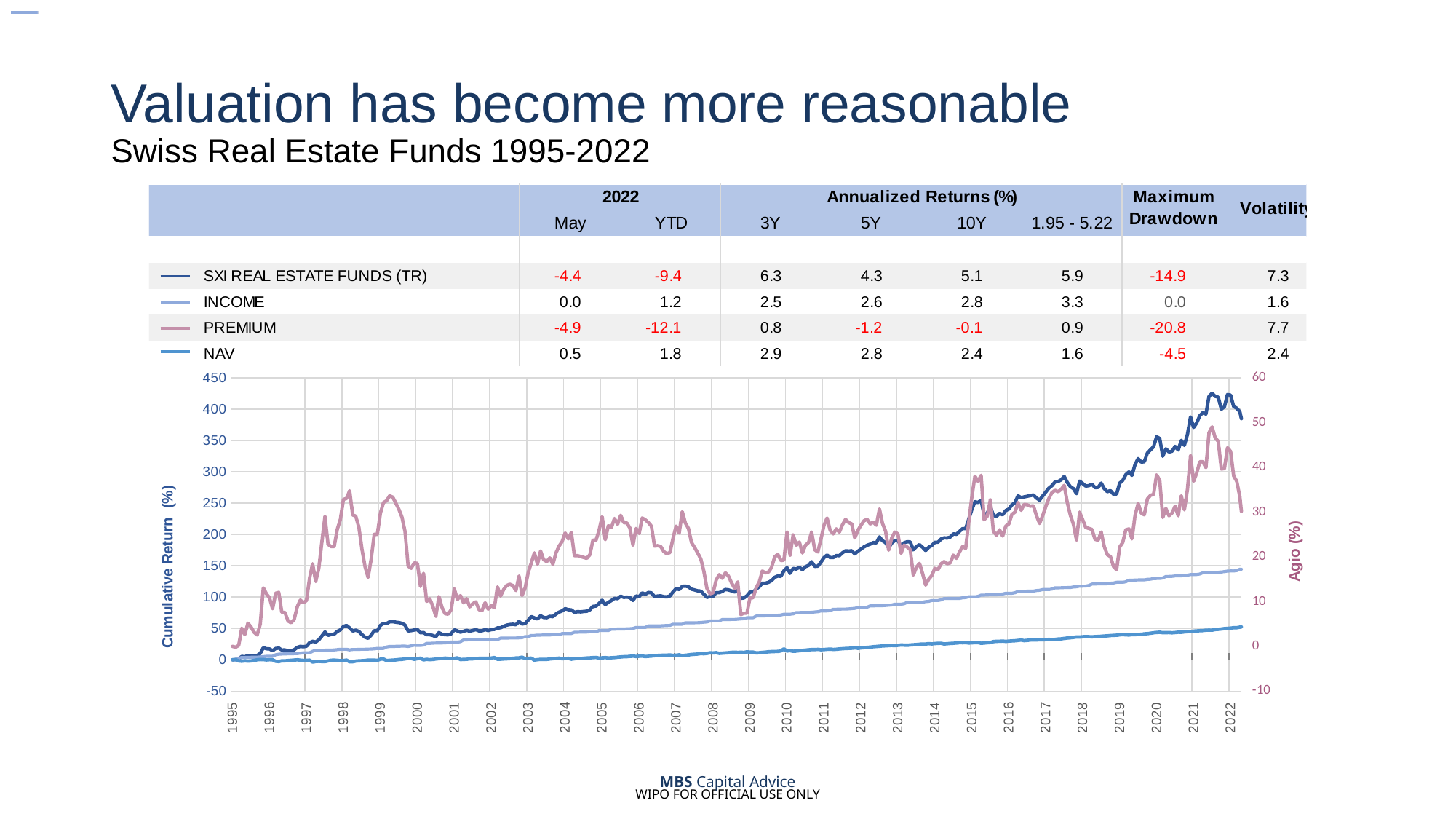
Does the INCOME line rise or fall along the x axis from 1995 to 2022? rise Is the cumulative return of INCOME at the end of 2022 greater or less than 100? greater At the end of 2022, which line is higher on the left axis: SXI REAL ESTATE FUNDS (TR) or NAV? SXI REAL ESTATE FUNDS (TR) Does the SXI REAL ESTATE FUNDS (TR) line rise or fall overall from 1995 to 2022? rise Is the cumulative return of SXI REAL ESTATE FUNDS (TR) at the end of 2022 greater or less than 350? greater Which series reaches the highest cumulative return on the left axis in 2021? SXI REAL ESTATE FUNDS (TR) What is the label of the left vertical axis of the chart? Cumulative Return (%) Is the cumulative return of NAV at the end of 2022 greater or less than 100? less How many series are plotted in the chart? 4 What is the label of the right vertical axis of the chart? Agio (%) What is the first year shown on the x axis of the chart? 1995 What kind of chart is shown on the slide? line chart